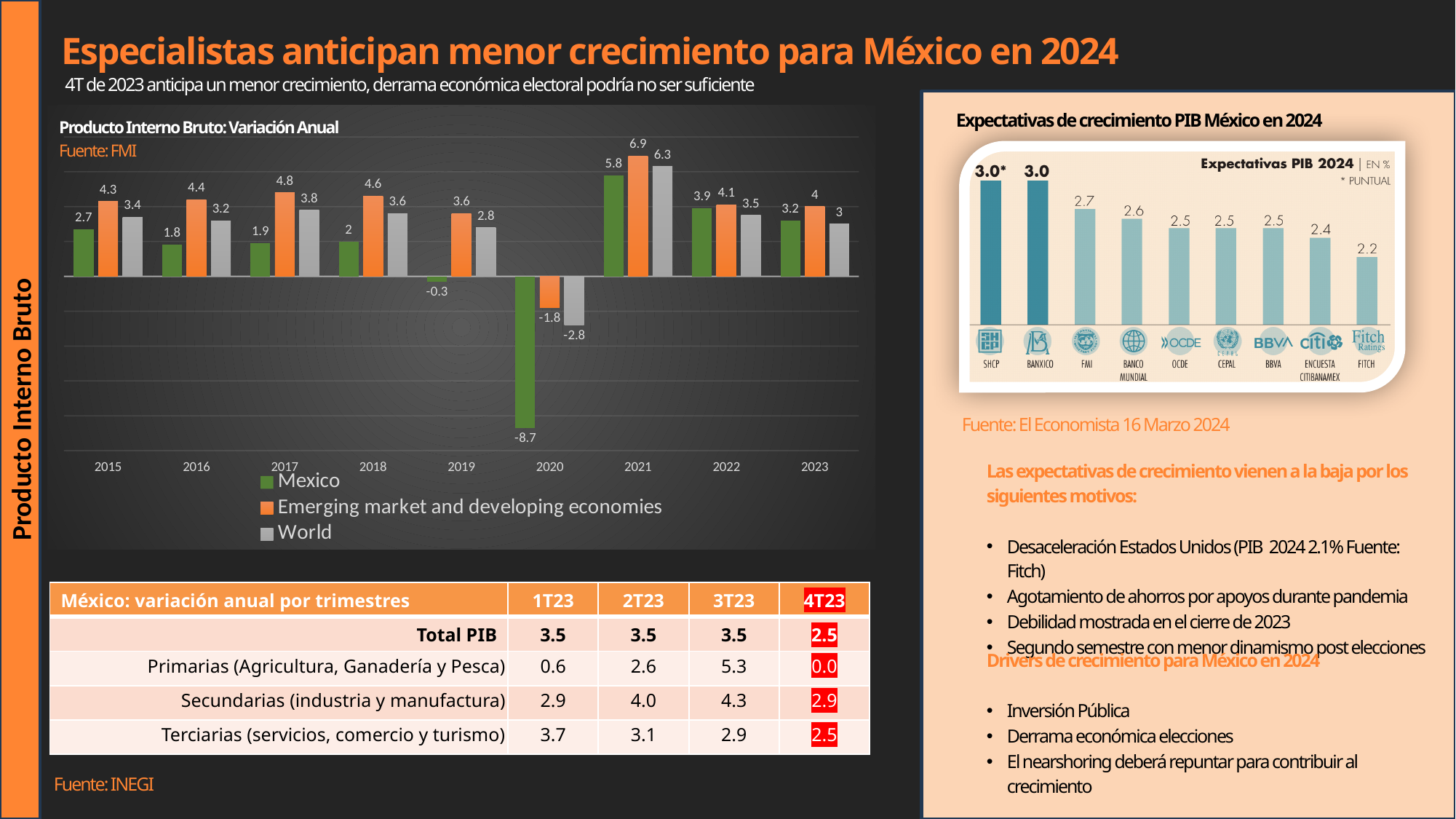
How many years are shown on the x axis of the 'Producto Interno Bruto: Variación Anual' chart? 9 In the 'Expectativas de crecimiento PIB México en 2024' chart, which institution has the lowest expectation? Fitch In the 'Producto Interno Bruto: Variación Anual' chart, which year has the highest value for Emerging market and developing economies? 2021 In the 'Expectativas de crecimiento PIB México en 2024' chart, what is the difference between the Banxico value and the Fitch value? 0.8 In the 'Producto Interno Bruto: Variación Anual' chart, which is larger in 2022: Mexico or World? Mexico In the 'Producto Interno Bruto: Variación Anual' chart, what is the value for World in 2021? 6.3 In the 'Producto Interno Bruto: Variación Anual' chart, which year has the lowest value for Mexico? 2020 In the 'Expectativas de crecimiento PIB México en 2024' chart, what is the value for FMI? 2.7 How many series does the legend of the 'Producto Interno Bruto: Variación Anual' chart list? 3 In the 'Producto Interno Bruto: Variación Anual' chart, what is the value for Mexico in 2020? -8.7 In the 'Producto Interno Bruto: Variación Anual' chart, what is the difference between the Emerging market and developing economies value and the Mexico value in 2023? 0.8 What kind of chart is 'Producto Interno Bruto: Variación Anual'? Bar chart